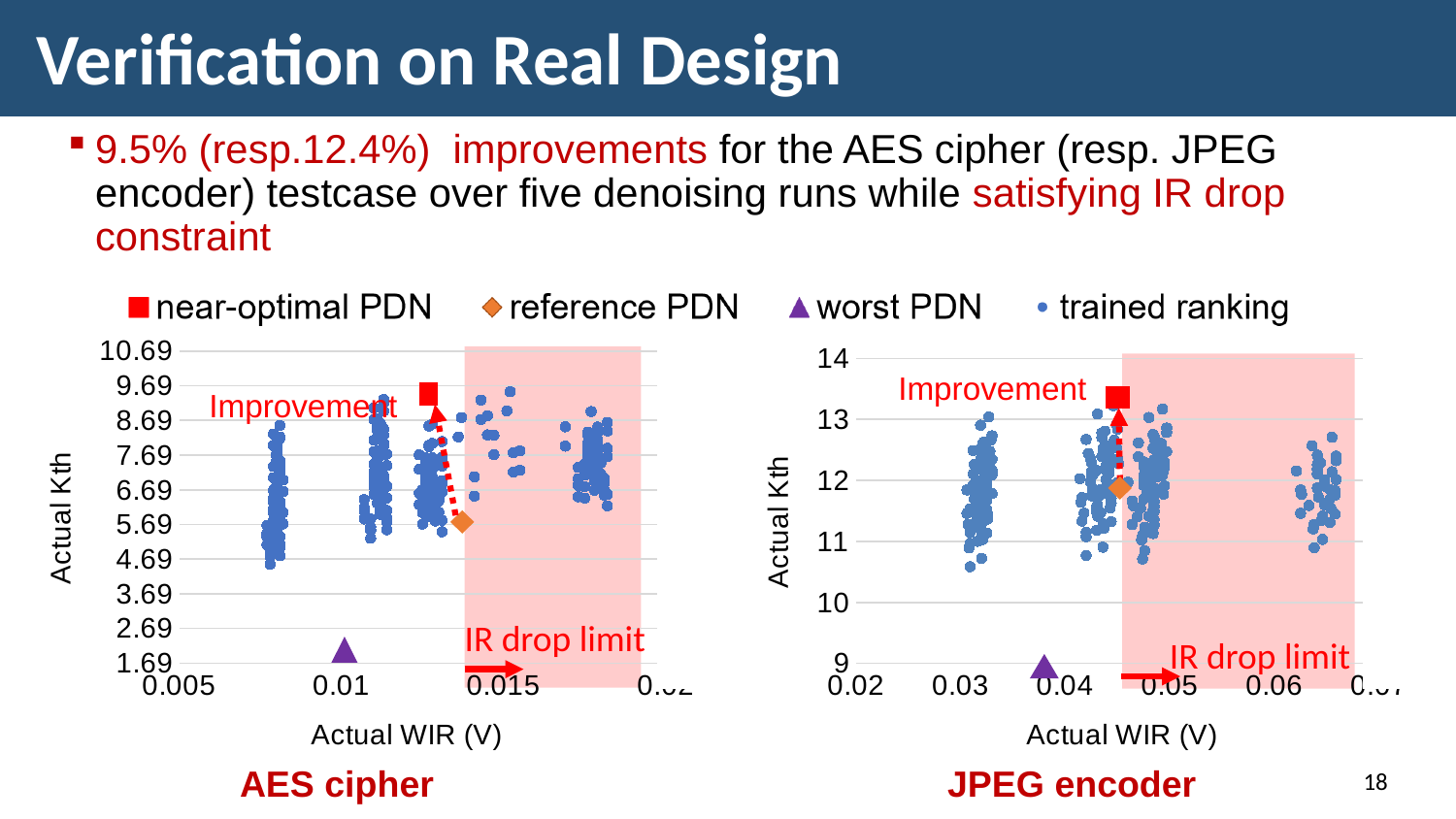
In the JPEG encoder chart, which of the three PDN markers has the lowest Actual Kth? worst PDN In the AES cipher chart, which has the higher Actual Kth: the near-optimal PDN or the reference PDN? near-optimal PDN In the JPEG encoder chart, is the Actual Kth value for the worst PDN greater or less than 10? less What kind of chart is the AES cipher chart? scatter chart In the AES cipher chart, is the Actual WIR value for the reference PDN greater or less than 0.015? less In the AES cipher chart, is the Actual Kth value for the worst PDN greater or less than 3.69? less What is the y-axis title of the JPEG encoder chart? Actual Kth What is the x-axis title of the AES cipher chart? Actual WIR (V) How many series does the legend list? 4